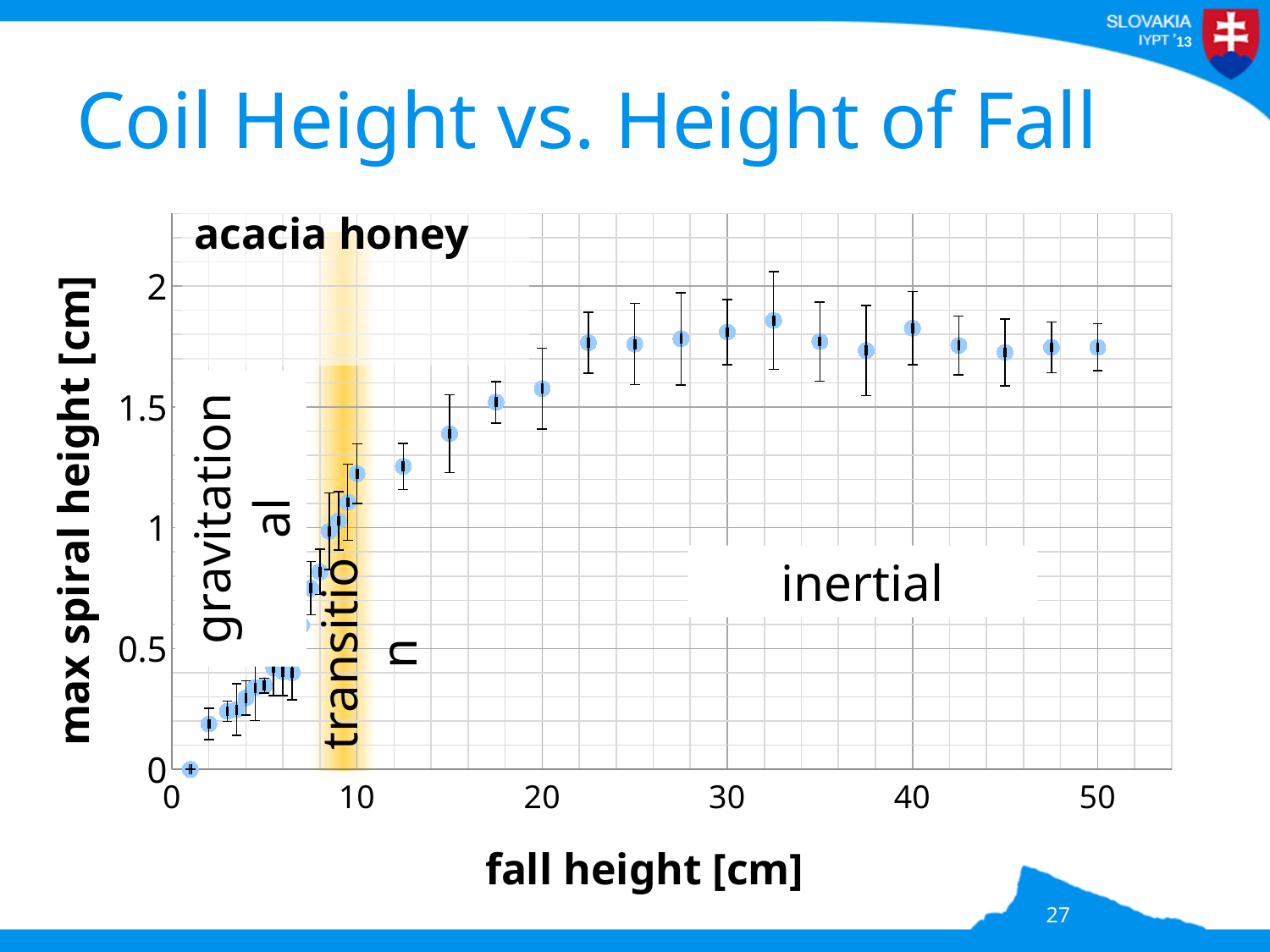
What kind of chart is shown on the slide? scatter plot Is the max spiral height at a fall height of 20 cm greater or less than 2? less Is the max spiral height at a fall height of 5 cm greater or less than 0.5? less Which substance is named in the label at the top of the chart? acacia honey What is the title of the slide's chart? Coil Height vs. Height of Fall Is the max spiral height at a fall height of 15 cm greater or less than 1? greater As fall height increases from 0 to 20 cm, does the max spiral height rise or fall? rise Which has the larger max spiral height: a fall height of 10 cm or a fall height of 20 cm? 20 cm Which has the larger max spiral height: a fall height of 5 cm or a fall height of 30 cm? 30 cm